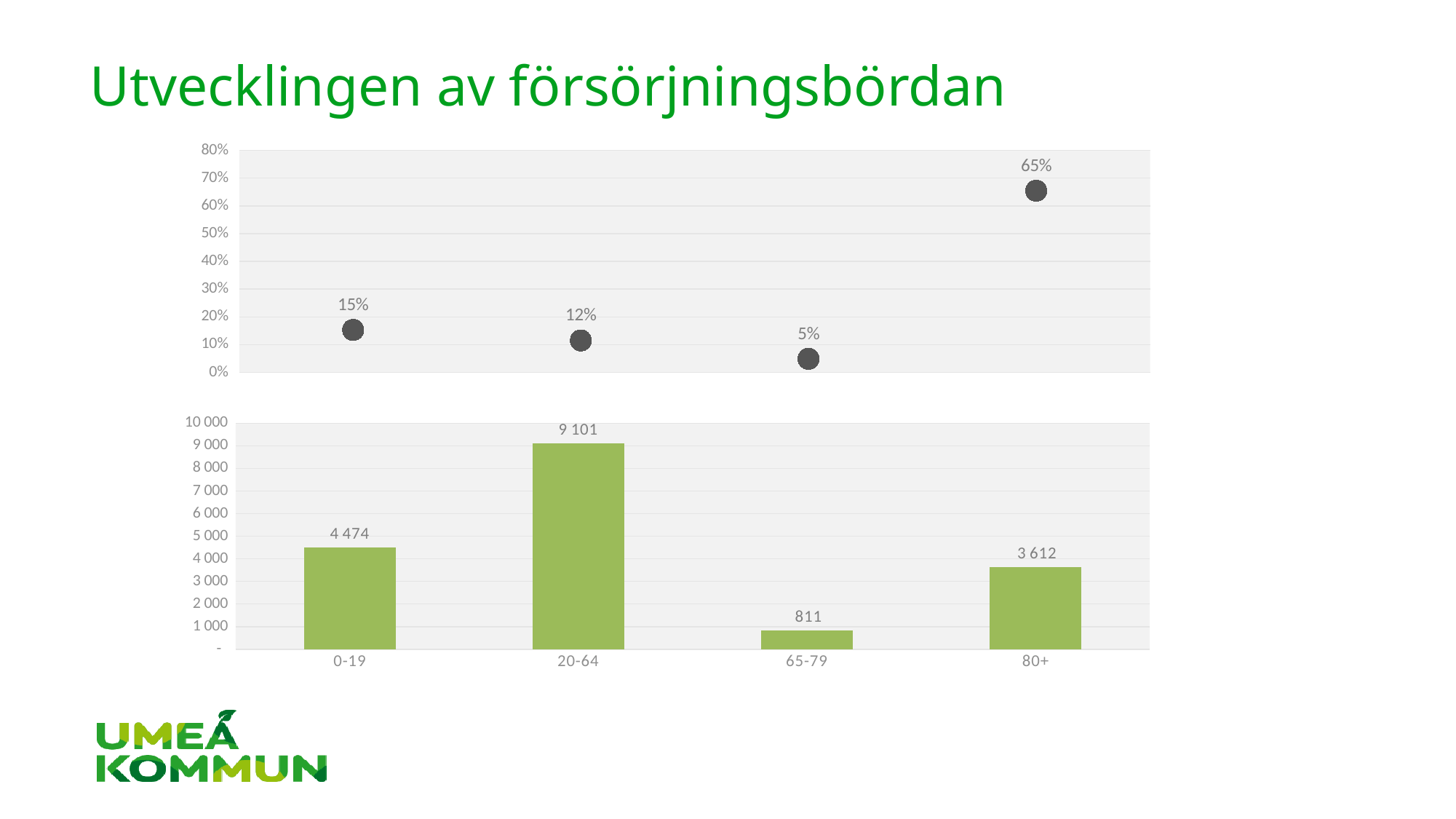
In the bottom bar chart, what is the value for the 80+ age group? 3 612 In the bottom bar chart, which age group has the highest value? 20-64 In the bottom bar chart, which age group has the lowest value? 65-79 In the top chart, what percentage is shown for the 65-79 age group? 5% In the bottom bar chart, which is larger: the value for 0-19 or the value for 80+? 0-19 How many age groups are shown on the x axis of the bottom bar chart? 4 In the bottom bar chart, what is the difference between the values for 0-19 and 80+? 862 In the top chart, which age group has the lowest percentage? 65-79 In the bottom bar chart, what is the value for the 20-64 age group? 9 101 In the top chart, what is the difference between the percentages for 0-19 and 20-64? 3% In the top chart, what percentage is shown for the 80+ age group? 65% What kind of chart is the bottom chart on the slide? Bar chart